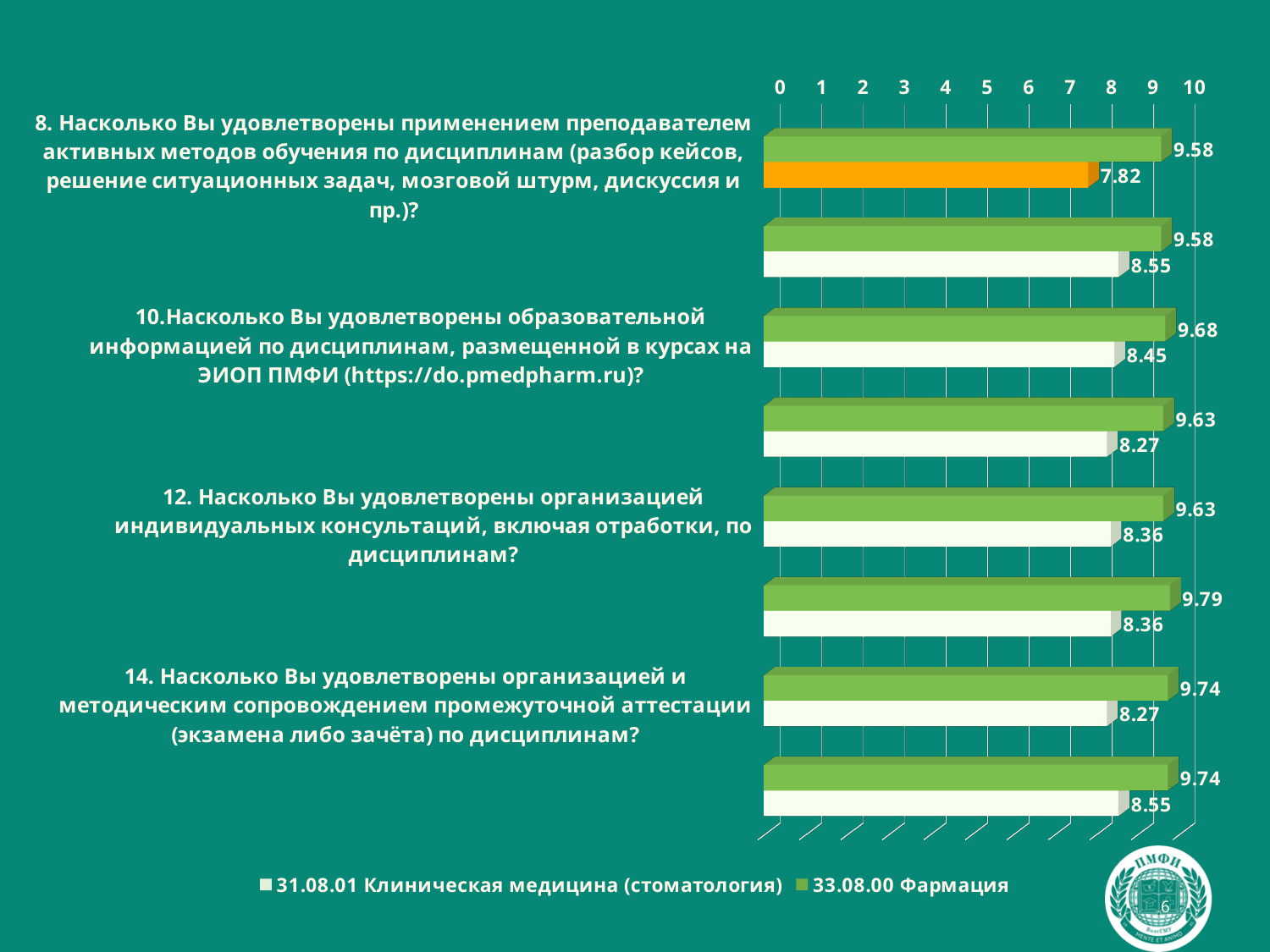
What is the value for 31.08.01 Клиническая медицина (стоматология) on question 8 (применение преподавателем активных методов обучения)? 7.82 Among the labelled questions (8, 10, 12, 14), which has the lowest value for 31.08.01 Клиническая медицина (стоматология)? Question 8 On question 10, which series has the larger value: 33.08.00 Фармация or 31.08.01 Клиническая медицина (стоматология)? 33.08.00 Фармация What is the value for 31.08.01 Клиническая медицина (стоматология) on question 12 (организация индивидуальных консультаций)? 8.36 Is the value for 31.08.01 Клиническая медицина (стоматология) on question 12 greater or less than 8? greater What is the value for 33.08.00 Фармация on question 10 (образовательная информация на ЭИОП ПМФИ)? 9.68 What is the value for 33.08.00 Фармация on question 14 (организация промежуточной аттестации)? 9.74 How many series does the legend list? 2 What is the value for 33.08.00 Фармация on question 8 (применение преподавателем активных методов обучения)? 9.58 What kind of chart is shown on the slide? Bar chart What is the difference between the 33.08.00 Фармация and 31.08.01 Клиническая медицина (стоматология) values on question 8? 1.76 What is the difference between the 33.08.00 Фармация and 31.08.01 Клиническая медицина (стоматология) values on question 14? 1.47